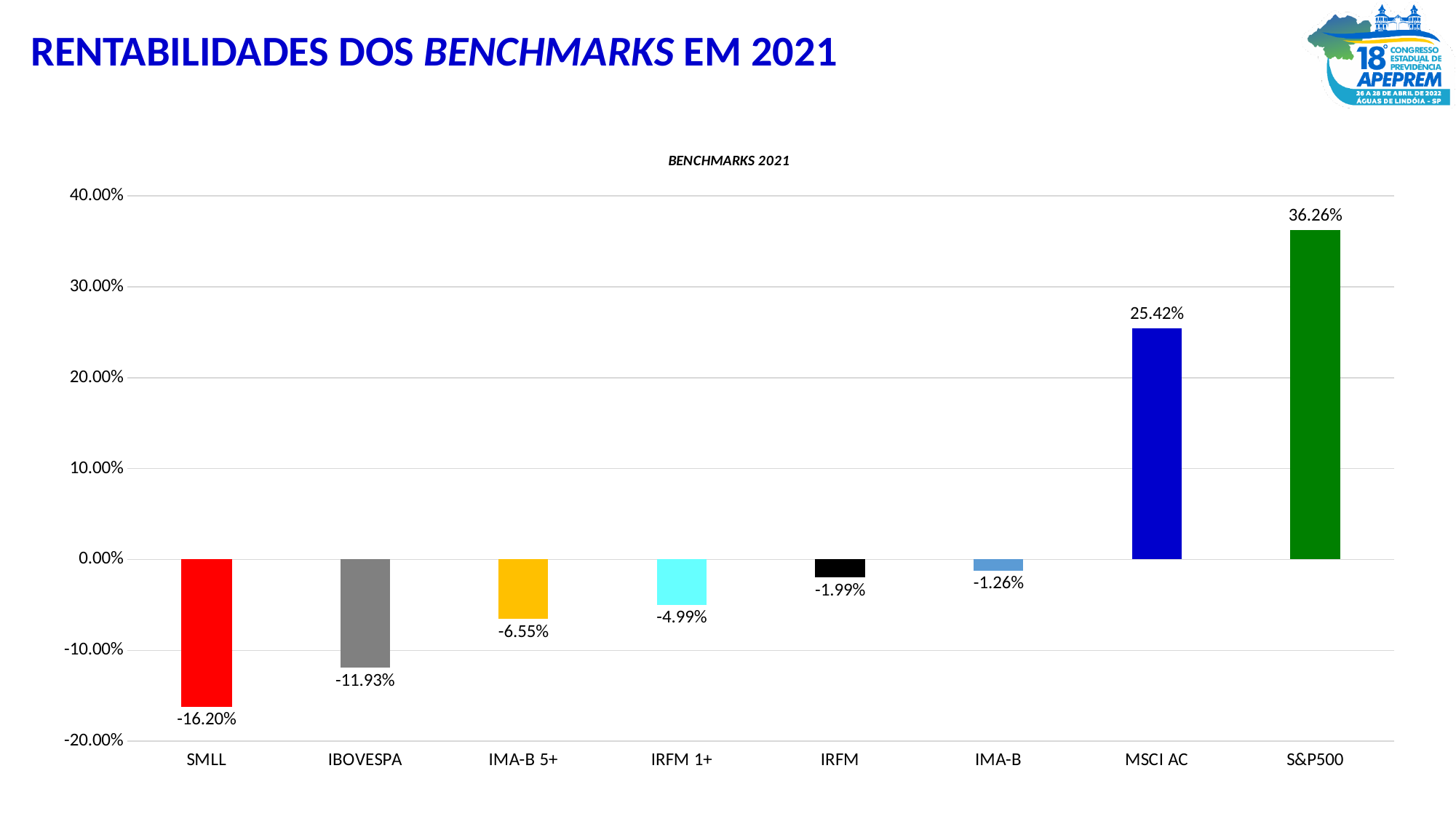
Is the value for MSCI AC greater or less than 20.00%? greater What is the value for IMA-B? -1.26% How many categories are shown on the chart? 8 What is the difference between the values for S&P500 and MSCI AC? 10.84% Which category has the lowest value? SMLL What is the value for IBOVESPA? -11.93% Which category has the highest value? S&P500 What is the title of the chart? BENCHMARKS 2021 What is the value for S&P500? 36.26% What colour is the bar for SMLL? red What kind of chart is shown on the slide? bar chart Which is larger, the value for IRFM 1+ or the value for IMA-B 5+? IRFM 1+